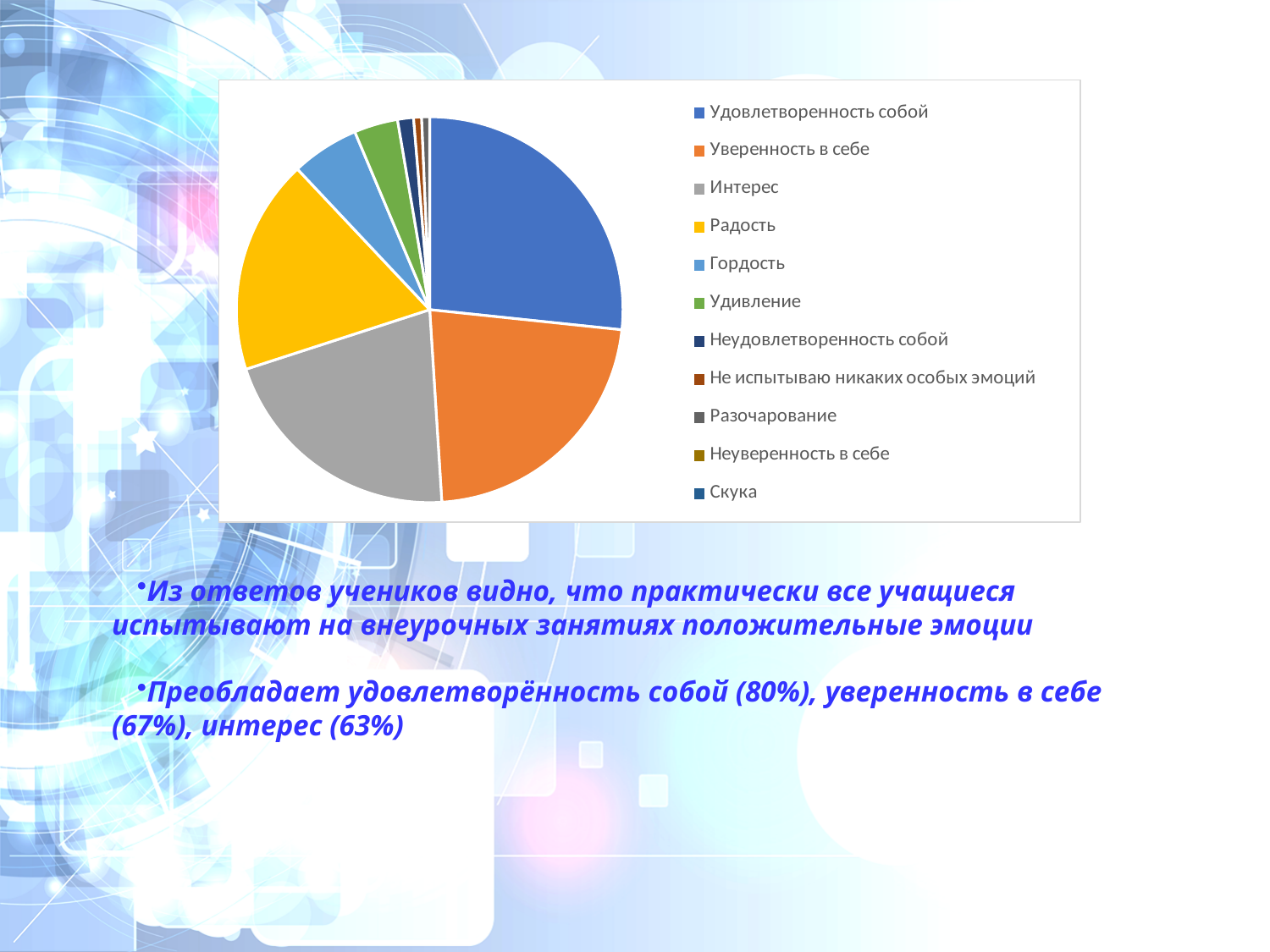
Which slice is larger, Удовлетворенность собой or Радость? Удовлетворенность собой How many categories does the legend of the pie chart list? 11 What colour is the slice for Радость in the pie chart? yellow Which category is shown in orange in the pie chart? Уверенность в себе How many slices does the pie chart have? 9 What kind of chart is shown on the slide? pie chart Which slice is larger, Радость or Гордость? Радость Which slice is larger, Интерес or Гордость? Интерес Which category has the largest slice in the pie chart? Удовлетворенность собой